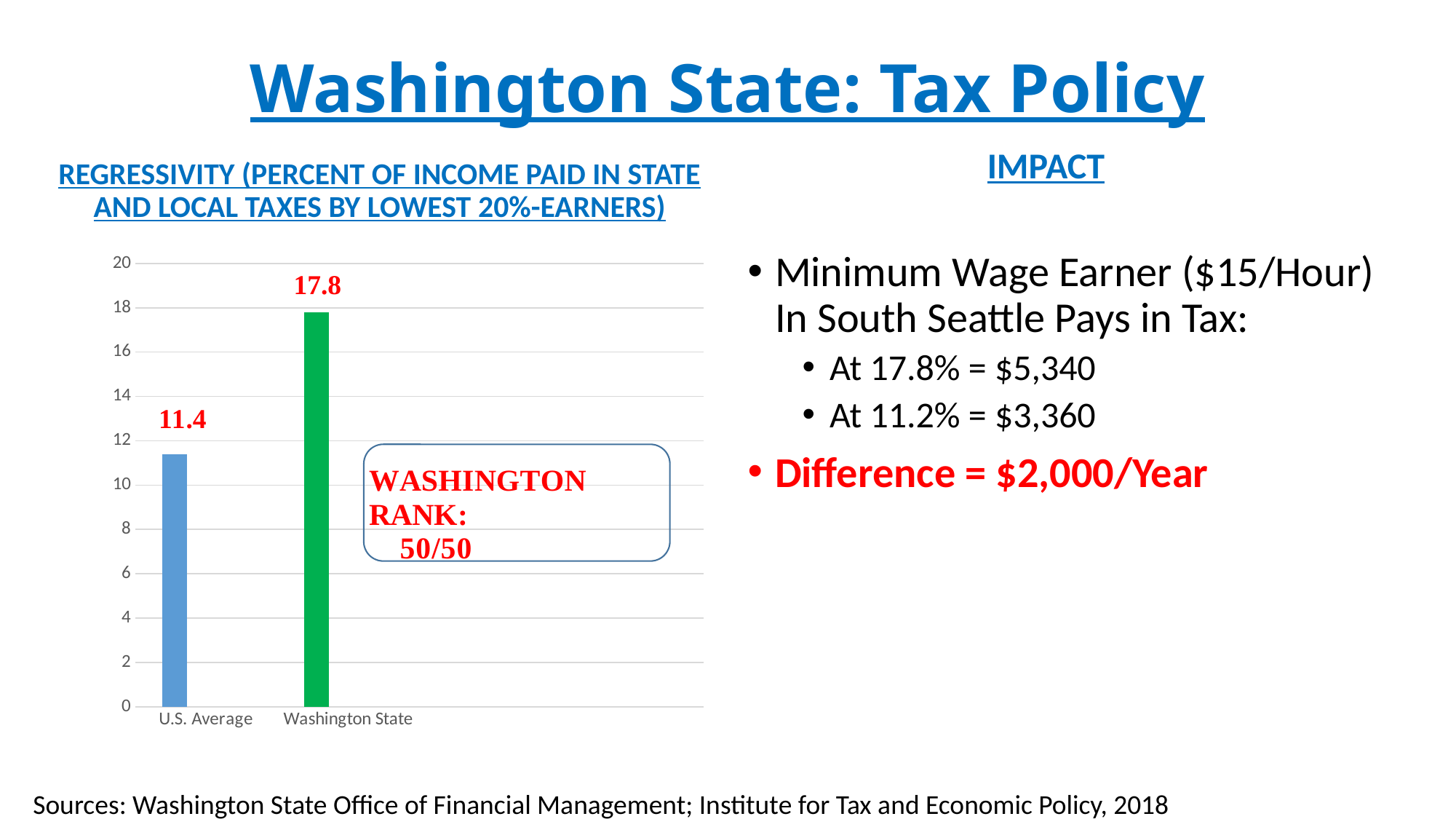
What colour is the bar for Washington State? green What kind of chart is shown on the slide? bar chart What is the difference between the Washington State value and the U.S. Average value? 6.4 How many categories are shown on the chart? 2 What is the value for Washington State? 17.8 What is the maximum value shown on the chart's vertical axis? 20 What is the value for U.S. Average? 11.4 Is the value for Washington State greater or less than 16? greater Which category has the lowest value? U.S. Average Is the value for U.S. Average greater or less than 12? less Which is larger, the value for U.S. Average or the value for Washington State? Washington State Which category has the highest value? Washington State